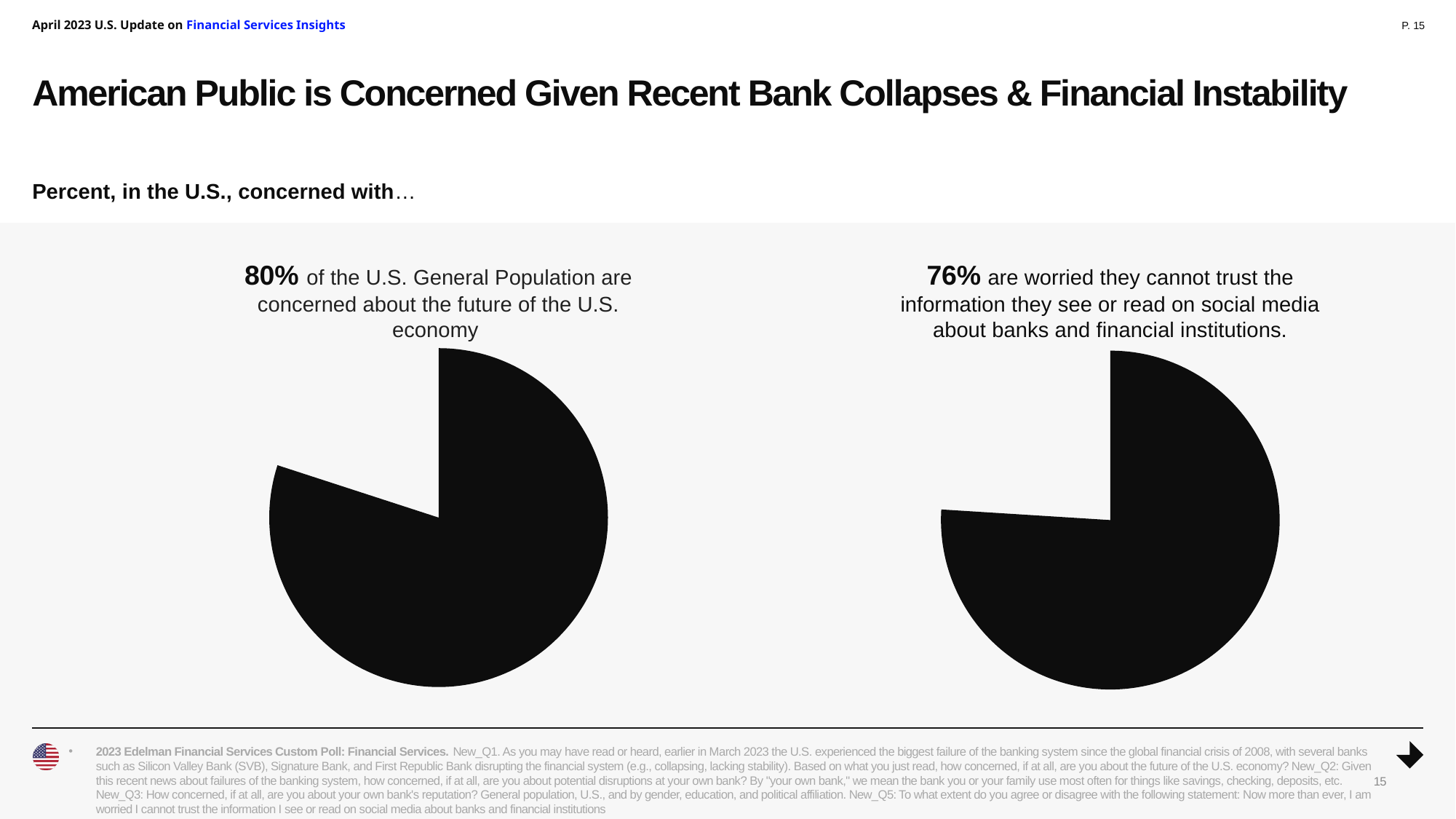
What colour is the filled slice in both pie charts? Black What kind of chart is used on the left side of the slide to show concern about the future of the U.S. economy? Pie chart What kind of chart is used on the right side of the slide to show worry about trusting social media information? Pie chart On the right pie chart, what percent are worried they cannot trust the information they see or read on social media about banks and financial institutions? 76% How many pie charts are shown on the slide? 2 Which is larger: the share concerned about the future of the U.S. economy (left chart) or the share worried they cannot trust social media information about banks (right chart)? Concerned about the future of the U.S. economy (80%) On the right pie chart, what share of the pie is filled in black? 76% On the left pie chart, what percent of the U.S. General Population are concerned about the future of the U.S. economy? 80% On the left pie chart, what share of the pie is filled in black? 80% What is the difference in percentage points between the left chart's value (80%) and the right chart's value (76%)? 4 percentage points What is the subtitle above the charts that introduces what the percentages represent? Percent, in the U.S., concerned with… Is the value shown on the right pie chart greater or less than 50%? greater